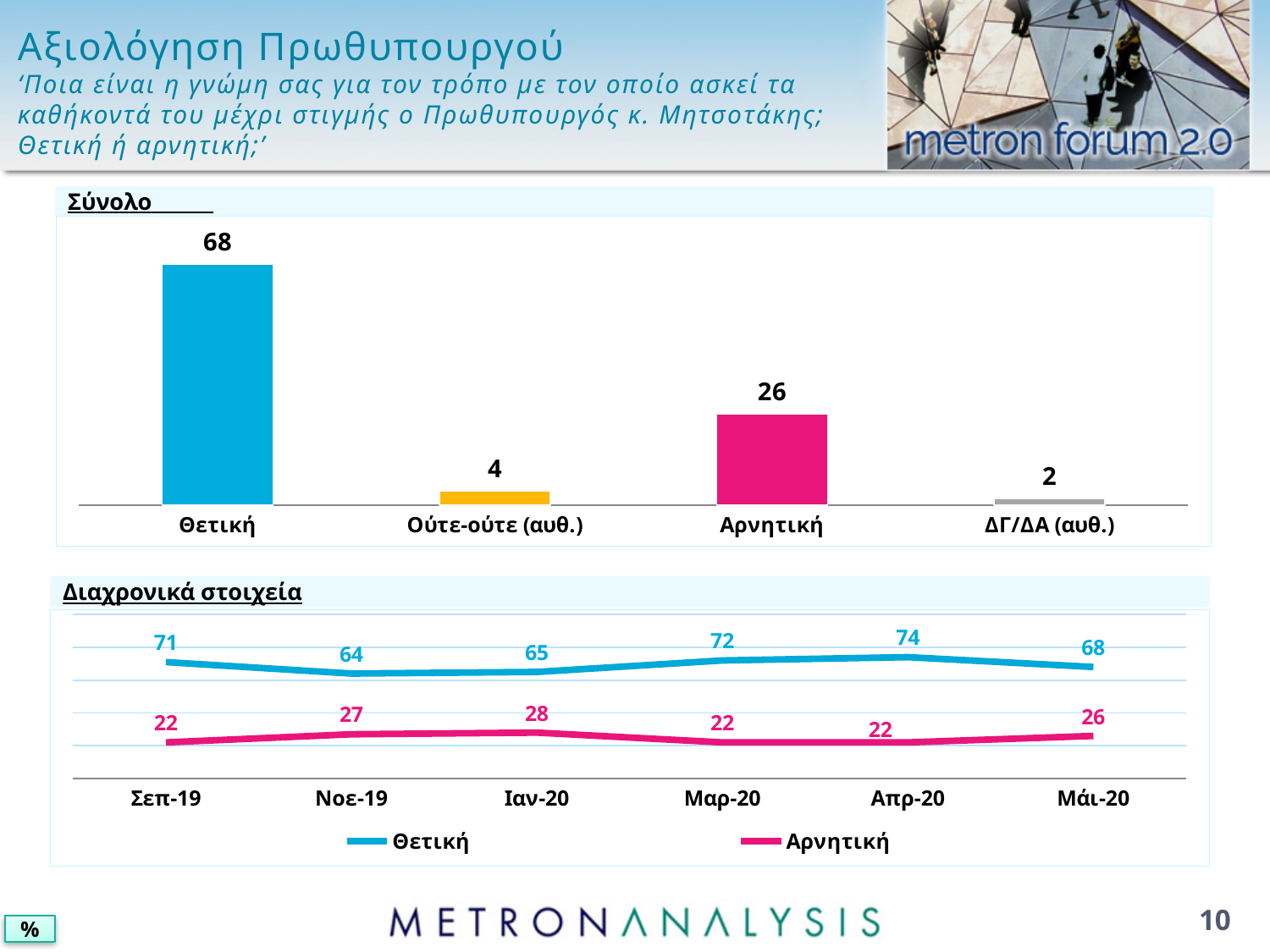
In the 'Διαχρονικά στοιχεία' line chart, does Θετική rise or fall from Απρ-20 to Μάι-20? fall In the 'Διαχρονικά στοιχεία' line chart, how many series does the legend list? 2 In the 'Διαχρονικά στοιχεία' line chart, at which date is Θετική highest? Απρ-20 In the 'Διαχρονικά στοιχεία' line chart, what is the value of Αρνητική for Ιαν-20? 28 In the 'Σύνολο' bar chart, which category has the lowest value? ΔΓ/ΔΑ (αυθ.) In the 'Διαχρονικά στοιχεία' line chart, what is the value of Θετική for Απρ-20? 74 What kind of chart is the 'Σύνολο' chart? bar chart In the 'Σύνολο' bar chart, how many categories are shown? 4 In the 'Σύνολο' bar chart, what is the value for Αρνητική? 26 In the 'Σύνολο' bar chart, what is the value for Θετική? 68 In the 'Σύνολο' bar chart, what is the difference between Θετική and Αρνητική? 42 In the 'Διαχρονικά στοιχεία' line chart, which is larger for Νοε-19: Θετική or Αρνητική? Θετική